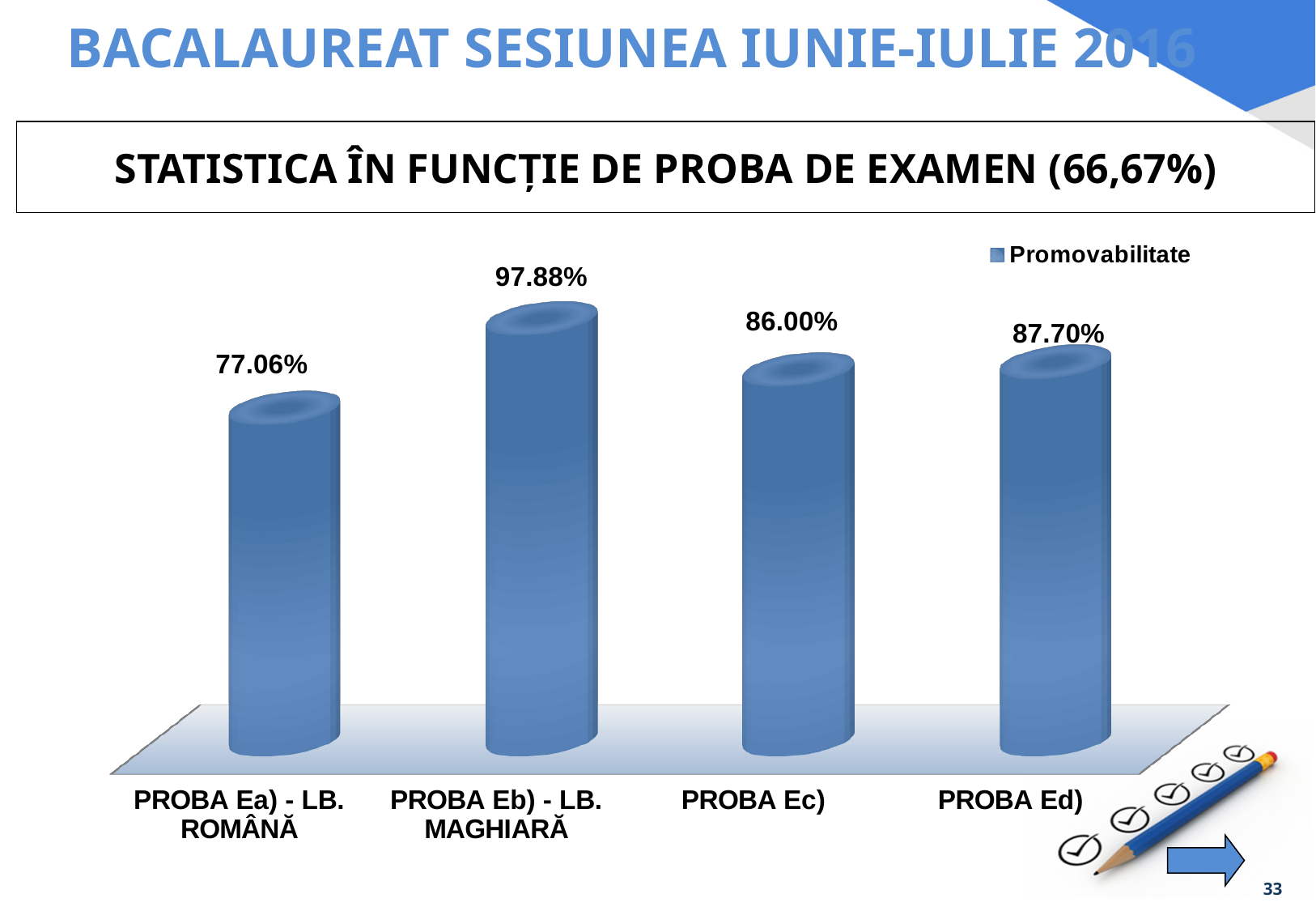
Which exam test has the lowest Promovabilitate? PROBA Ea) - LB. ROMÂNĂ What is the Promovabilitate value for PROBA Ed)? 87.70% What is the difference in Promovabilitate between PROBA Ed) and PROBA Ec)? 1.70% What kind of chart is shown on the slide? Bar chart What is the Promovabilitate value for PROBA Ea) - LB. ROMÂNĂ? 77.06% Which has a higher Promovabilitate, PROBA Ec) or PROBA Ea) - LB. ROMÂNĂ? PROBA Ec) What is the Promovabilitate value for PROBA Eb) - LB. MAGHIARĂ? 97.88% What is the difference in Promovabilitate between PROBA Eb) - LB. MAGHIARĂ and PROBA Ea) - LB. ROMÂNĂ? 20.82% What is the Promovabilitate value for PROBA Ec)? 86.00% How many exam tests are shown in the chart? 4 How many series does the legend list? 1 Which exam test has the highest Promovabilitate? PROBA Eb) - LB. MAGHIARĂ